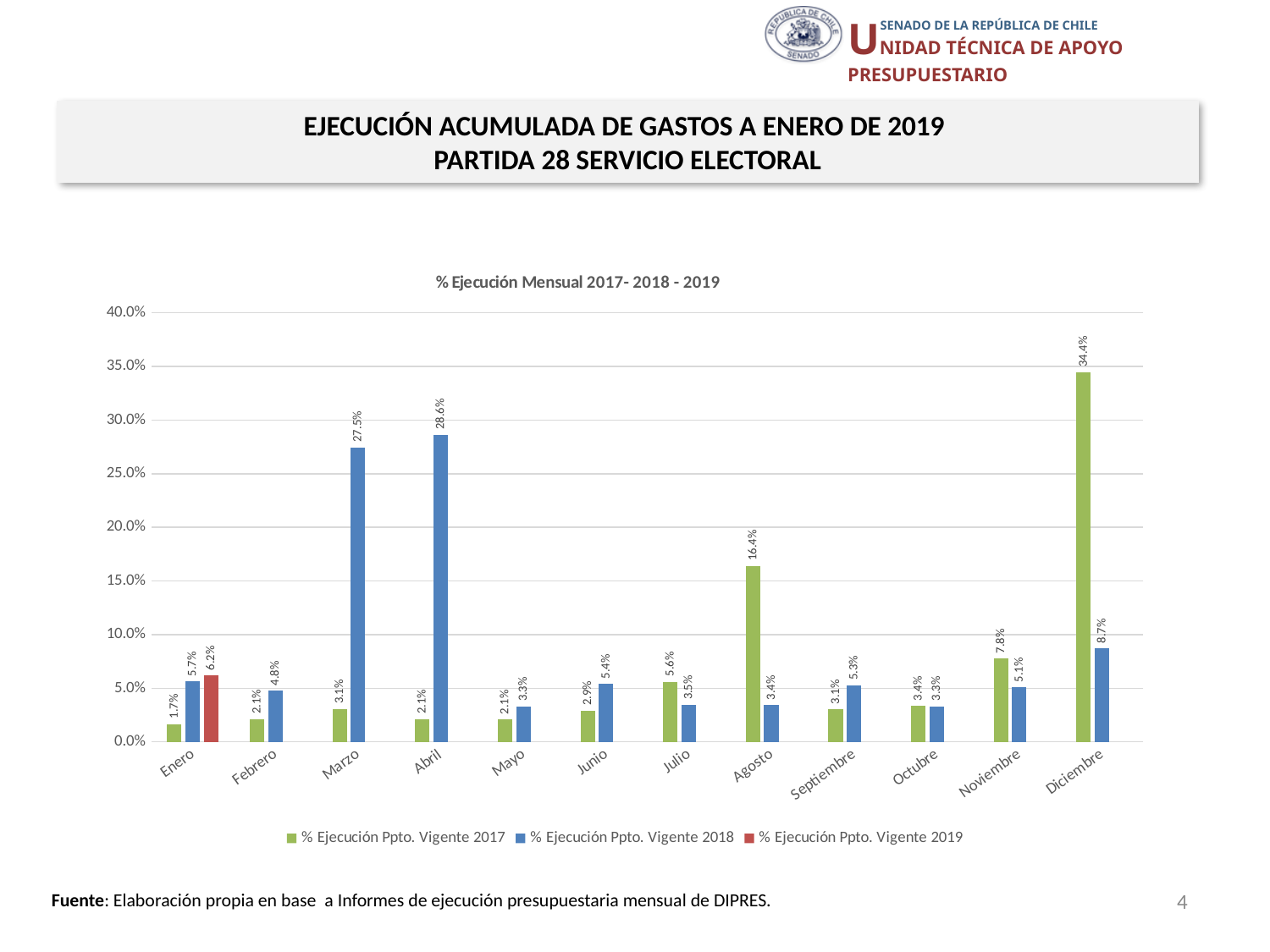
In Noviembre, which series is larger: % Ejecución Ppto. Vigente 2017 or % Ejecución Ppto. Vigente 2018? % Ejecución Ppto. Vigente 2017 What is the value for % Ejecución Ppto. Vigente 2018 in Abril? 28.6% What is the difference between the 2018 and 2017 values in Marzo? 24.4% Which month has the lowest value for % Ejecución Ppto. Vigente 2017? Enero Which month has the highest value for % Ejecución Ppto. Vigente 2017? Diciembre How many months are shown on the x axis? 12 What is the value for % Ejecución Ppto. Vigente 2017 in Agosto? 16.4% What is the value for % Ejecución Ppto. Vigente 2019 in Enero? 6.2% Which month has the highest value for % Ejecución Ppto. Vigente 2018? Abril Is the value for % Ejecución Ppto. Vigente 2017 in Diciembre greater or less than 30.0%? greater How many series does the legend list? 3 What type of chart is shown on the slide? Bar chart